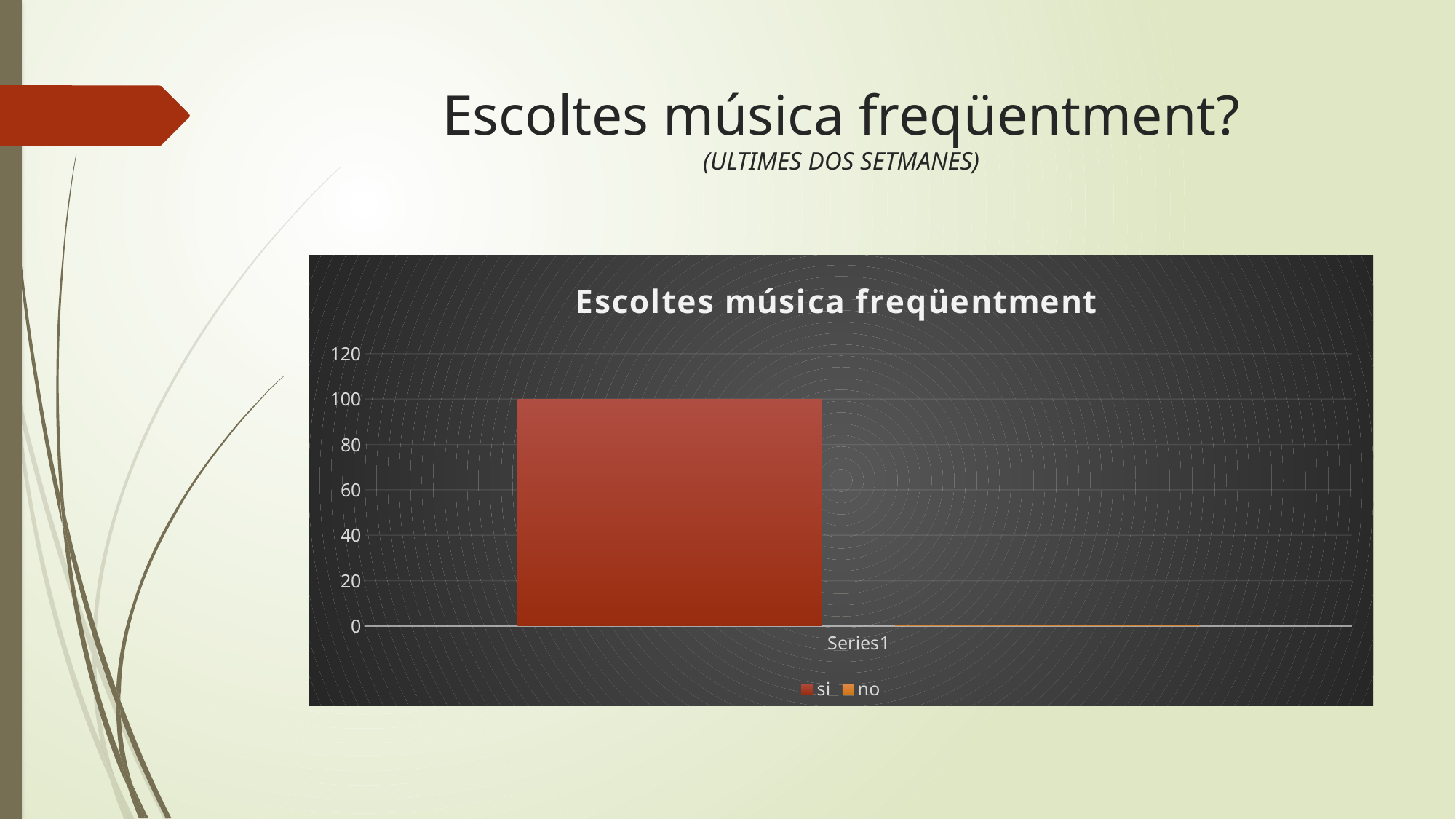
Is the value for 'si' greater or less than 120? less What is the value of the 'si' bar in the chart? 100 Which series has the highest value in the chart? si Which is larger in the chart, the value for 'si' or the value for 'no'? si What type of chart is shown on the slide? bar chart How many categories are shown on the x axis of the chart? 1 What is the label of the category on the x axis? Series1 What is the title of the chart? Escoltes música freqüentment What are the series names listed in the chart legend? si, no How many series does the chart legend list? 2 Is the value for 'si' greater or less than 80? greater Which series has the lowest value in the chart? no